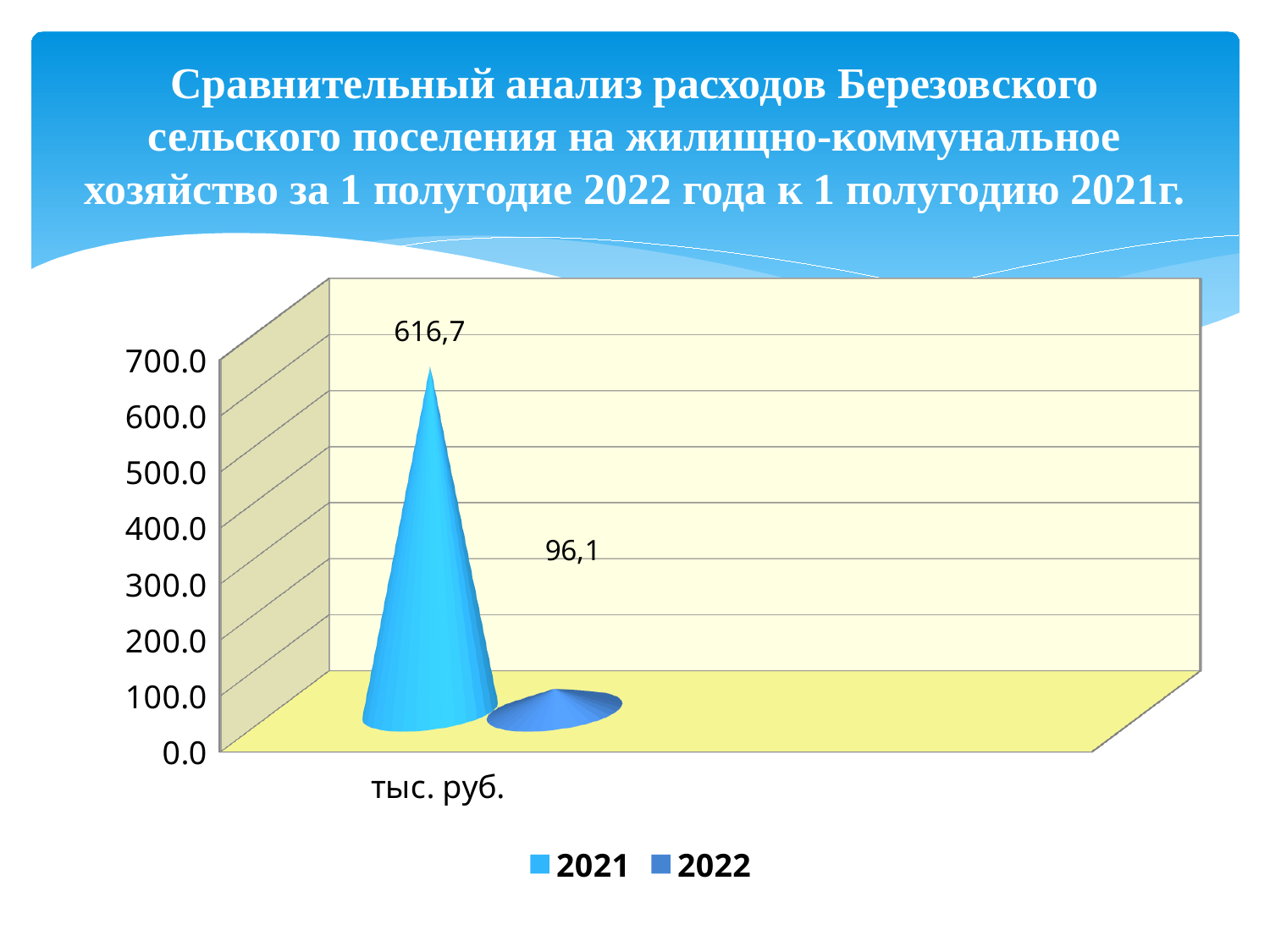
What is the difference between the 2021 value and the 2022 value? 520,6 Is the value for 2021 greater or less than 600.0? greater Which series has the higher value, 2021 or 2022? 2021 What is the value for 2022? 96,1 Is the value for 2022 greater or less than 100.0? less How many series does the legend list? 2 Which series has the highest value? 2021 Which series has the lowest value? 2022 What kind of chart is shown on the slide? bar chart What is the value for 2021? 616,7 What is the highest value shown on the vertical axis? 700.0 What is the category label shown on the x axis? тыс. руб.